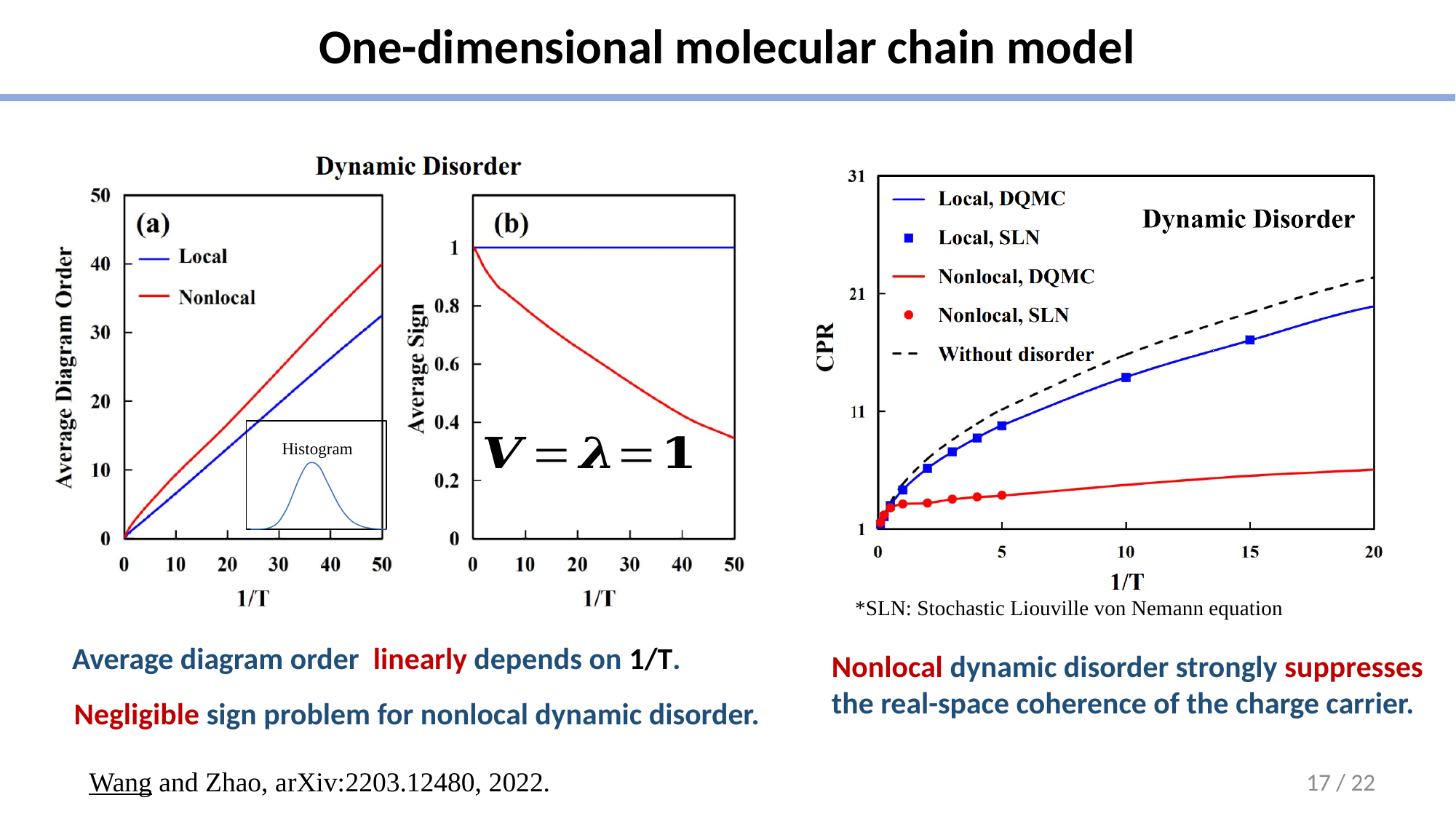
In chart (a), Average Diagram Order vs 1/T, is the Local value at 1/T = 50 greater or less than 40? less In the CPR chart on the right, is the Nonlocal, DQMC value at 1/T = 20 greater or less than 11? less In chart (a), Average Diagram Order vs 1/T, do the values rise or fall as 1/T increases? rise In chart (b), Average Sign vs 1/T, is the Nonlocal value at 1/T = 50 greater or less than 0.4? less In the CPR chart on the right, how many series does the legend list? 5 In the CPR chart on the right, which legend entry is drawn as a dashed line? Without disorder In the CPR chart on the right, which has the higher CPR at 1/T = 20: Local, DQMC or Nonlocal, DQMC? Local, DQMC What kind of chart is the CPR chart on the right? line chart In chart (b), Average Sign vs 1/T, what is the Average Sign of the Local series across the whole range of 1/T? 1 In chart (a), Average Diagram Order vs 1/T, which series has the higher value at 1/T = 50? Nonlocal In chart (b), Average Sign vs 1/T, does the Nonlocal series rise or fall as 1/T increases? fall